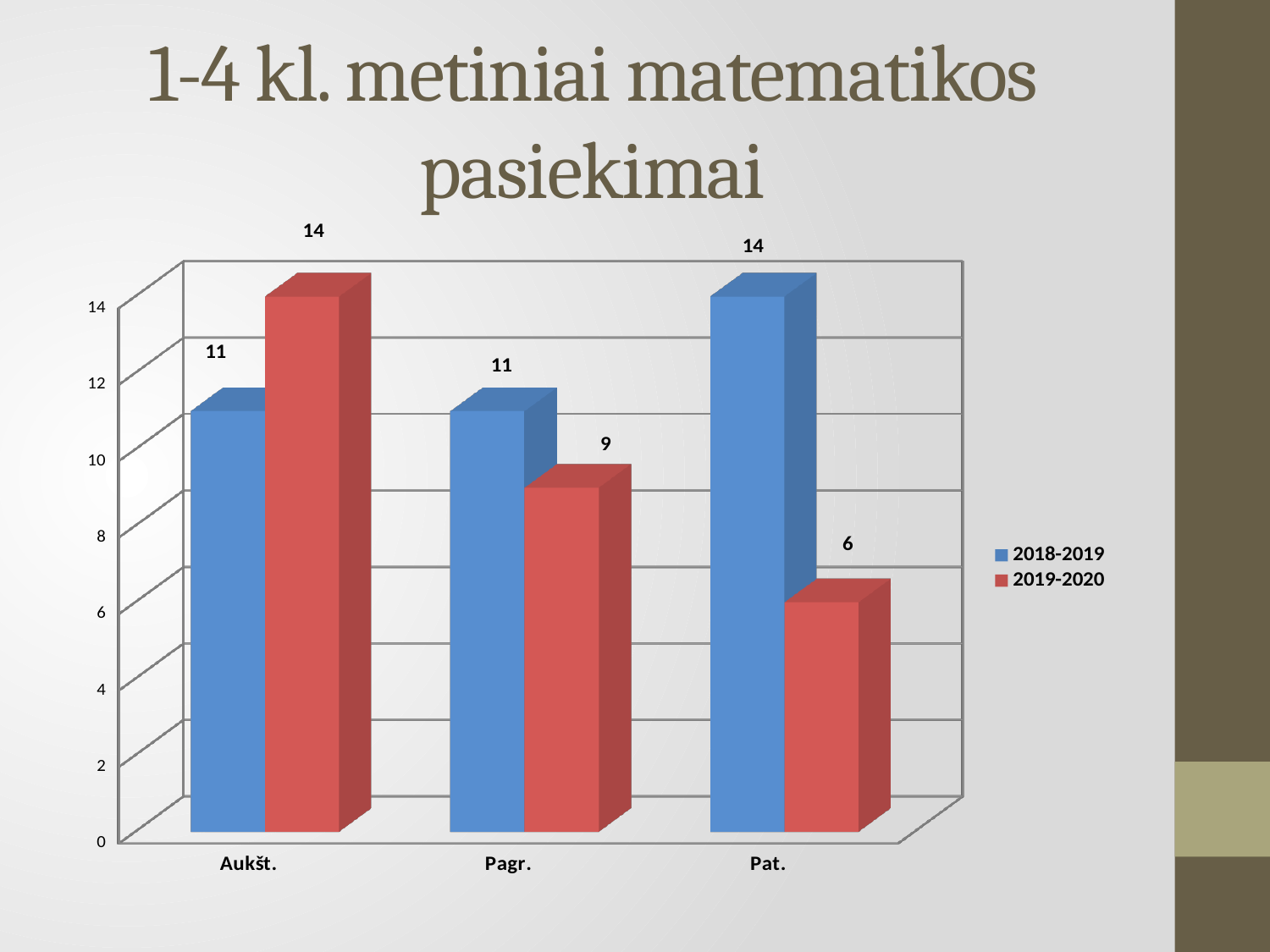
Which is larger for Pagr.: the 2018-2019 value or the 2019-2020 value? 2018-2019 What is the value for Pat. in the 2019-2020 series? 6 What is the value for Aukšt. in the 2019-2020 series? 14 What is the difference between the 2018-2019 and 2019-2020 values for Pat.? 8 How many categories are shown on the x axis? 3 What is the value for Pagr. in the 2019-2020 series? 9 What kind of chart is shown on the slide? Bar chart How many series does the legend list? 2 Which category has the lowest value in the 2019-2020 series? Pat. What is the value for Pat. in the 2018-2019 series? 14 Which category has the highest value in the 2018-2019 series? Pat. What is the value for Aukšt. in the 2018-2019 series? 11